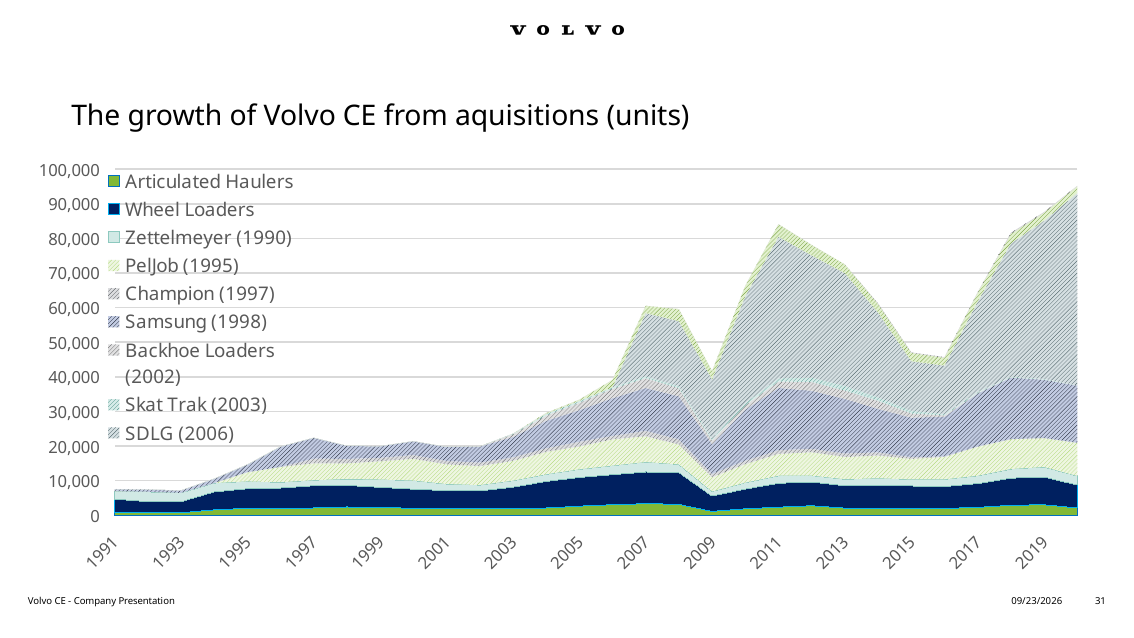
Is the total value for 1991 greater or less than 10,000? less Which is larger, the total value for 2011 or the total value for 2009? 2011 Is the total value for 2019 greater or less than 80,000? greater What is the title of the chart? The growth of Volvo CE from aquisitions (units) What kind of chart is shown on the slide? Stacked area chart Is the total value for 2015 greater or less than 60,000? less How many series does the legend list? 9 Which series is listed in the legend with the year 1998? Samsung (1998) Overall, do the total units rise or fall from 1991 to 2019? rise